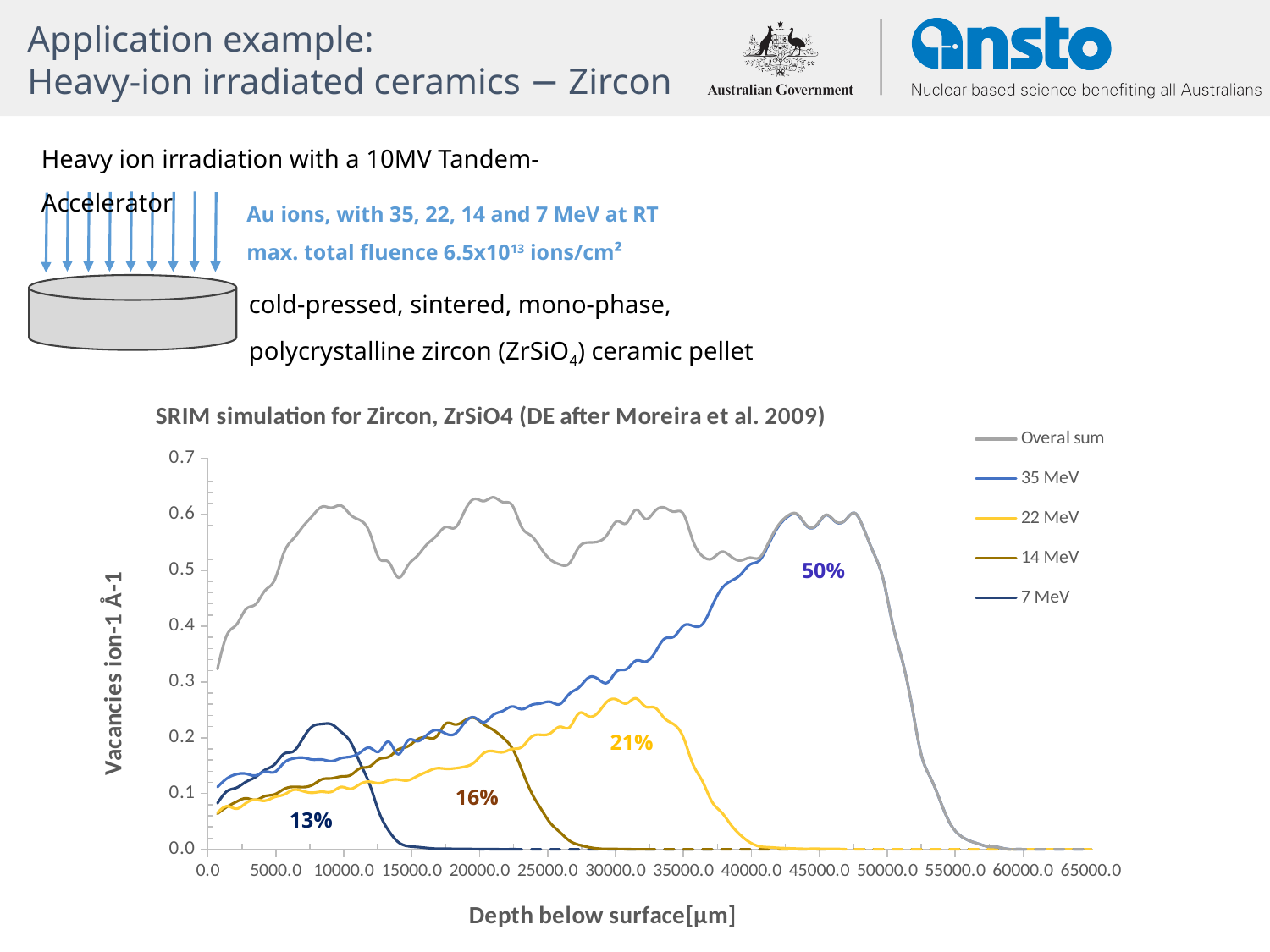
Which of the individual ion-energy series (35, 22, 14 or 7 MeV) drops to zero at the shallowest depth? 7 MeV What kind of chart is shown on the slide? line chart What is the label of the x axis of the chart? Depth below surface[μm] What percentage label is printed next to the 22 MeV curve? 21% What percentage label is printed next to the 35 MeV curve? 50% Is the peak value of the 35 MeV curve greater or less than 0.5? greater What is the title of the chart? SRIM simulation for Zircon, ZrSiO4 (DE after Moreira et al. 2009) What percentage label is printed next to the 7 MeV curve? 13% How many series does the chart legend list? 5 Which of the individual ion-energy series (35, 22, 14 or 7 MeV) reaches the highest vacancy value? 35 MeV Is the peak value of the 7 MeV curve greater or less than 0.3? less What percentage label is printed next to the 14 MeV curve? 16%